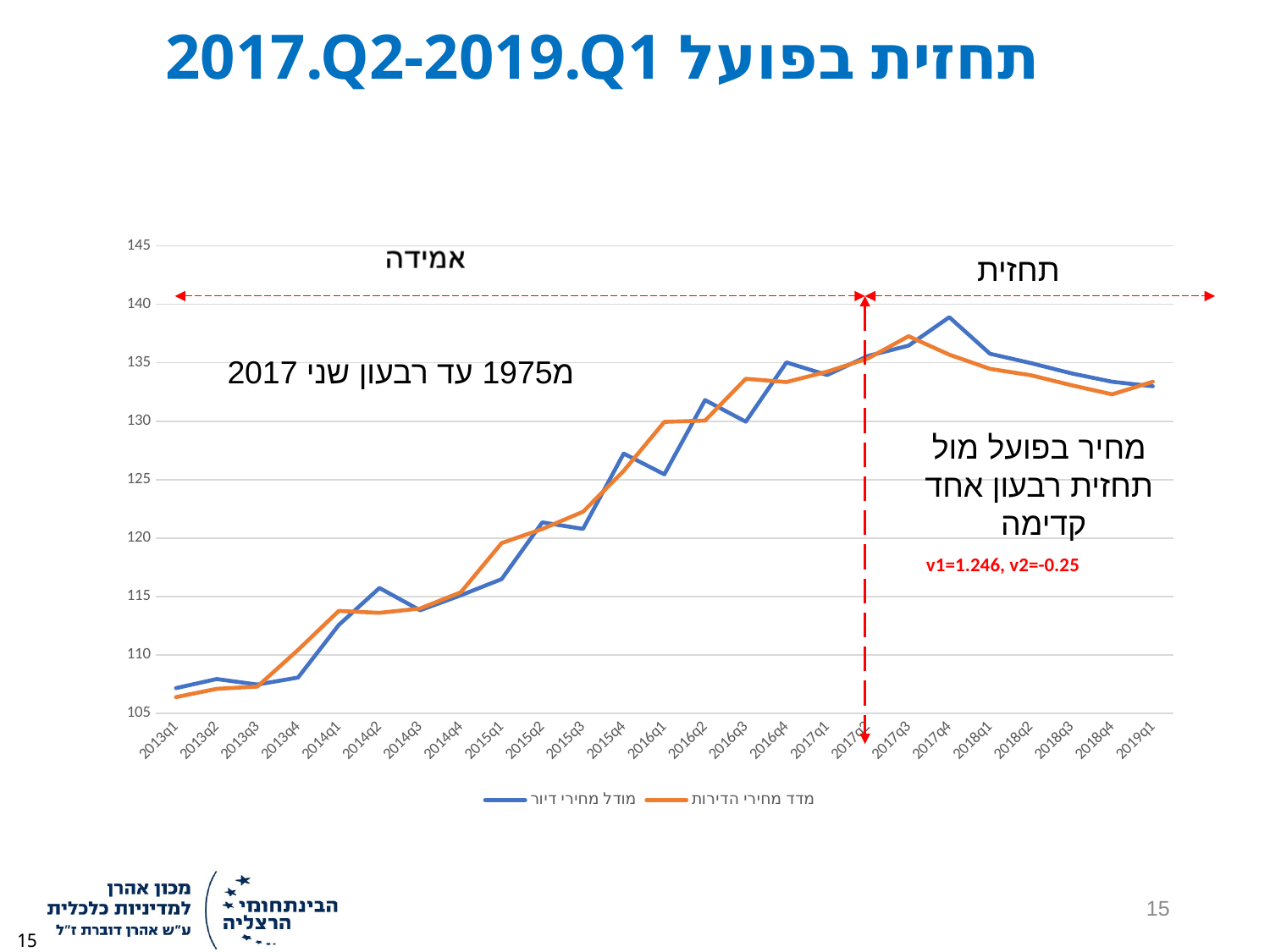
Is the value of the blue series (מודל מחירי דיור) at 2013q1 greater or less than 110? less At which quarter does the blue series (מודל מחירי דיור) reach its highest value? 2017q4 At which quarter does the orange series (מדד מחירי הדירות) have its lowest value? 2013q1 What is the title of the slide? תחזית בפועל 2017.Q2-2019.Q1 Do the values of the blue series (מודל מחירי דיור) rise or fall from 2017q4 to 2019q1? fall What kind of chart is shown on the slide? line chart At 2016q1, which series has the higher value, the blue (מודל מחירי דיור) or the orange (מדד מחירי הדירות)? מדד מחירי הדירות Which series is drawn in blue according to the legend? מודל מחירי דיור Is the value of the blue series (מודל מחירי דיור) at 2017q4 greater or less than 135? greater How many quarters are plotted along the x axis, from 2013q1 to 2019q1? 25 How many series does the legend list? 2 Do the values of the blue series (מודל מחירי דיור) rise or fall from 2013q1 to 2017q3? rise